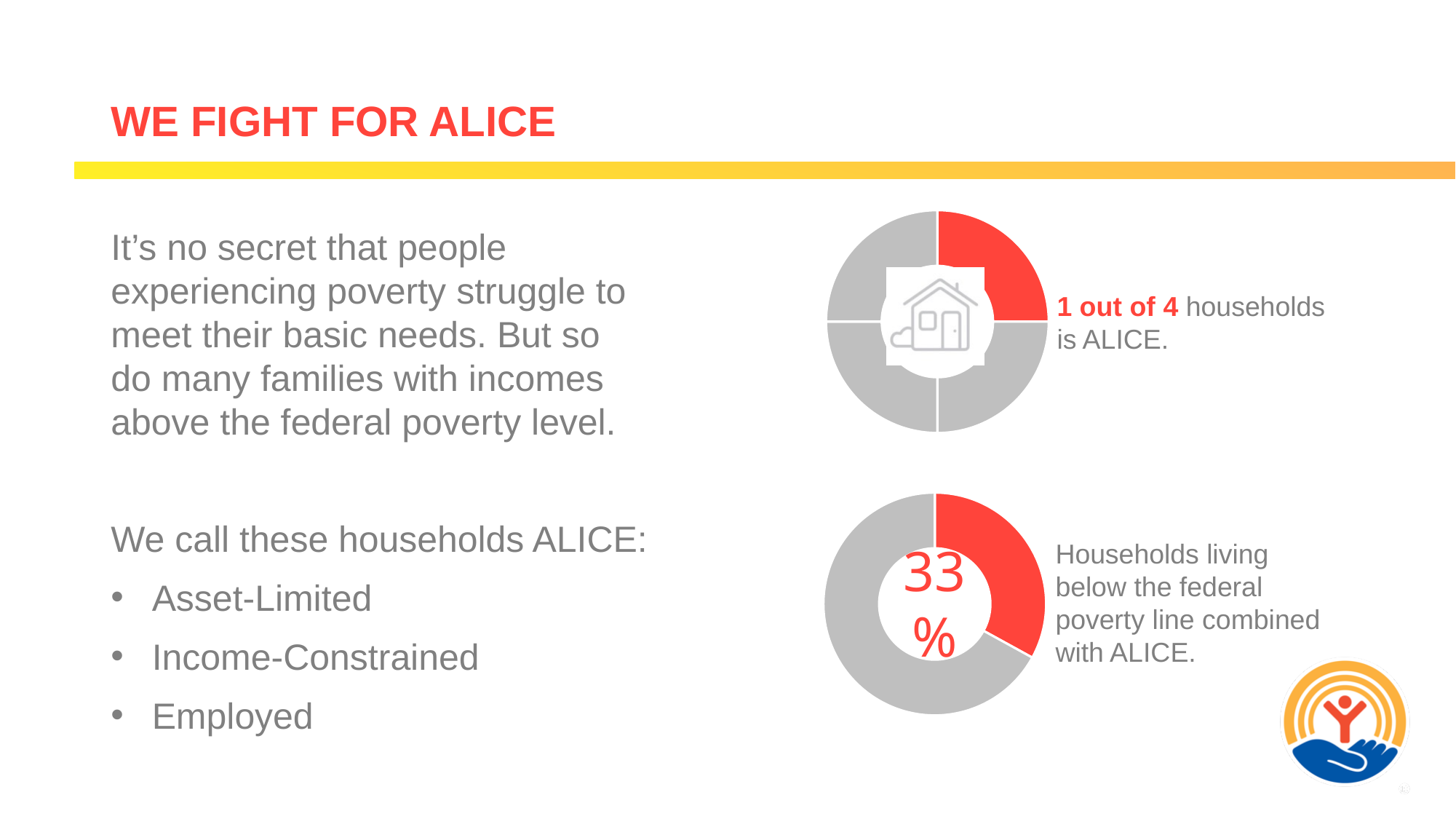
What kind of chart is the bottom chart on the right side of the slide? Pie chart (donut) What does the text next to the bottom chart say the 33% represents? Households living below the federal poverty line combined with ALICE In the top chart, which is larger: the red portion or the grey portion? Grey In the top chart, what share of households is ALICE according to the label? 1 out of 4 In the bottom chart, what percentage is printed in the centre for households living below the federal poverty line combined with ALICE? 33% In the bottom chart, is the red share greater or less than 50%? less What colour is used to highlight the ALICE share in both charts? Red In the top chart, is the red share greater or less than 50%? less In the bottom chart, which is larger: the red portion or the grey portion? Grey In the top chart, how many equal segments is the ring divided into? 4 What kind of chart is the top chart on the right side of the slide? Pie chart (donut)